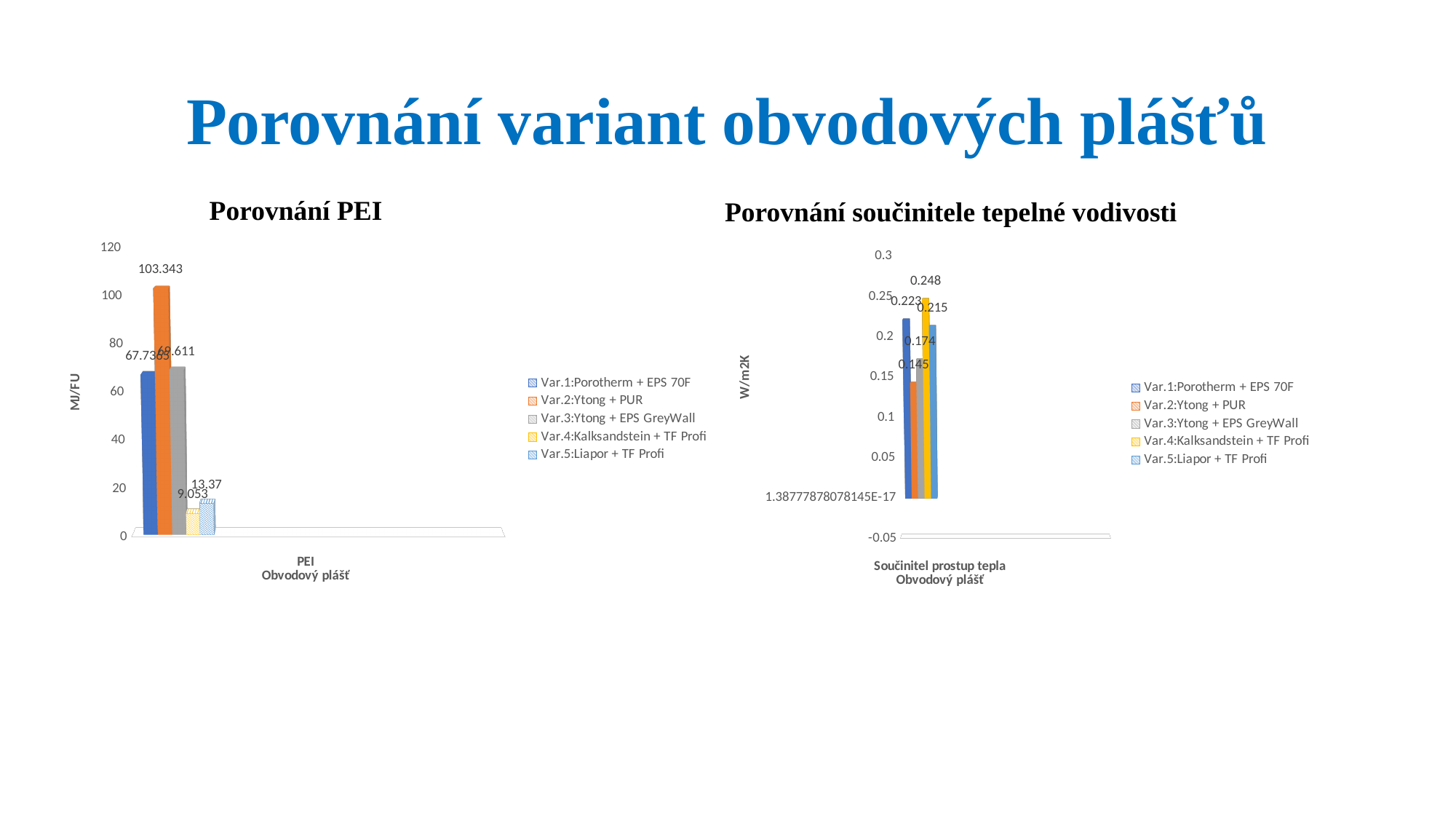
In the 'Porovnání PEI' chart, what is the value for Var.2:Ytong + PUR? 103.343 In the 'Porovnání součinitele tepelné vodivosti' chart, what is the value for Var.4:Kalksandstein + TF Profi? 0.248 In the 'Porovnání PEI' chart, which variant has the highest value? Var.2:Ytong + PUR In the 'Porovnání PEI' chart, what is the difference between the values for Var.5:Liapor + TF Profi and Var.4:Kalksandstein + TF Profi? 4.317 What kind of chart is the 'Porovnání PEI' chart? bar chart In the 'Porovnání PEI' chart, what is the value for Var.5:Liapor + TF Profi? 13.37 In the 'Porovnání součinitele tepelné vodivosti' chart, which variant has the lowest value? Var.2:Ytong + PUR In the 'Porovnání PEI' chart, is the value for Var.1:Porotherm + EPS 70F greater or less than 60? greater In the 'Porovnání PEI' chart, what is the value for Var.4:Kalksandstein + TF Profi? 9.053 In the 'Porovnání PEI' chart, which variant has the lowest value? Var.4:Kalksandstein + TF Profi In the 'Porovnání součinitele tepelné vodivosti' chart, what is the value for Var.2:Ytong + PUR? 0.145 How many series does the legend of the 'Porovnání součinitele tepelné vodivosti' chart list? 5